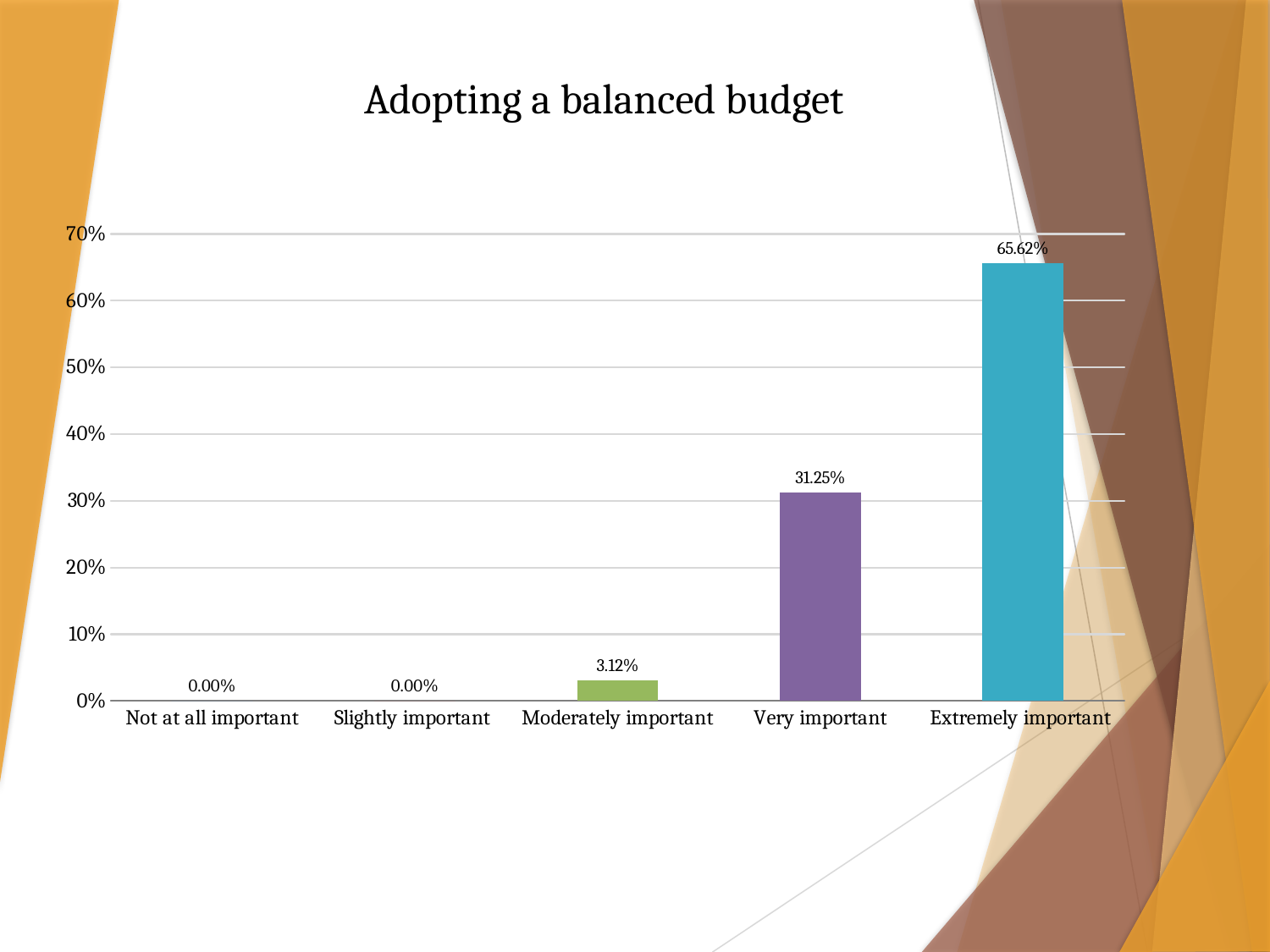
What is the value for Very important? 31.25% Is the value for Extremely important greater or less than 60%? greater How many categories are shown on the x axis? 5 What is the value for Moderately important? 3.12% What is the value for Not at all important? 0.00% What is the difference between the values for Extremely important and Very important? 34.37% What kind of chart is shown on the slide? Bar chart What is the title of the chart? Adopting a balanced budget What is the value for Extremely important? 65.62% Which is larger, the value for Very important or the value for Moderately important? Very important Do the values rise or fall moving from Not at all important to Extremely important along the x axis? Rise Which category has the highest value? Extremely important